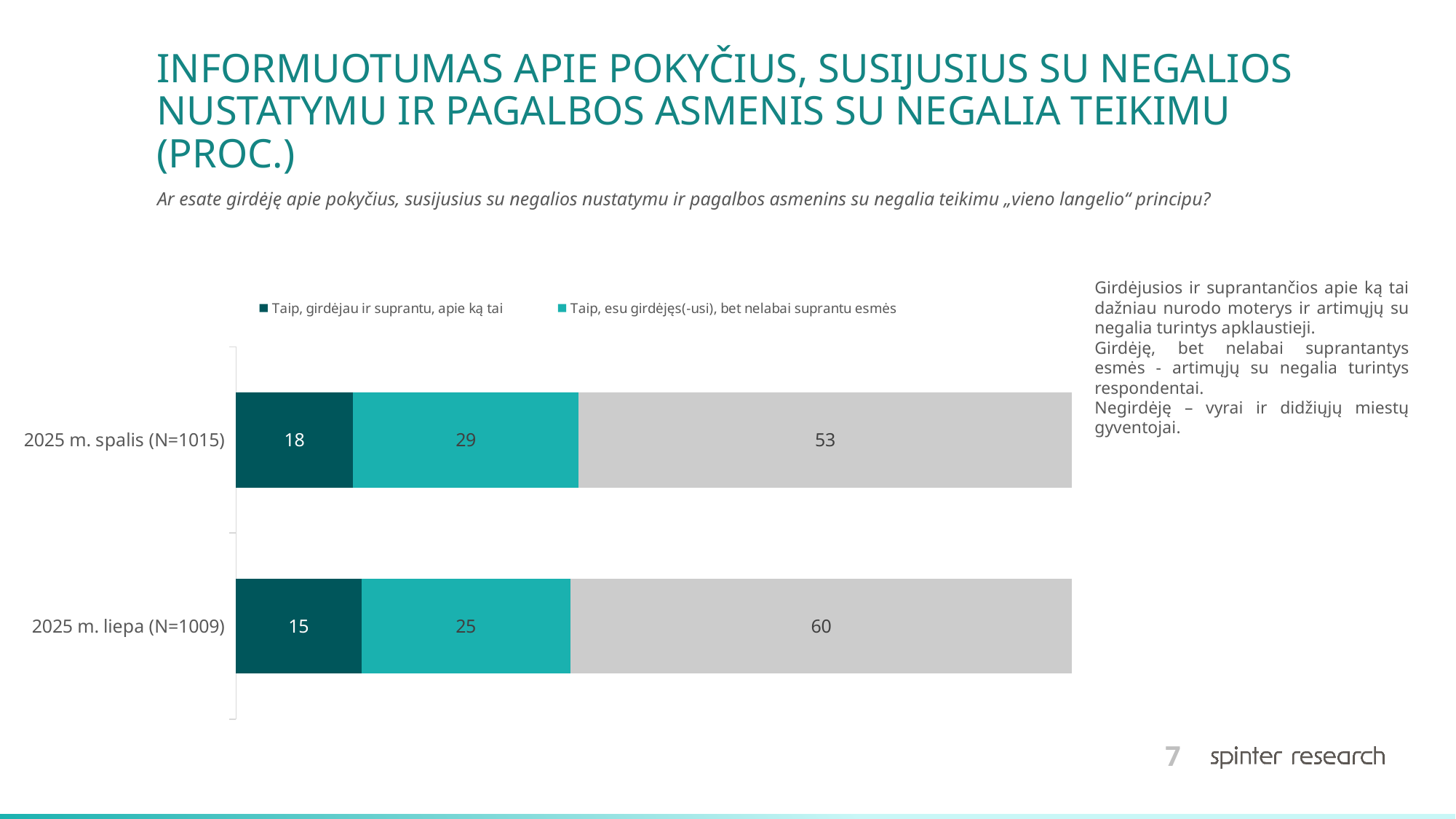
What is the value of the "Taip, esu girdėjęs(-usi), bet nelabai suprantu esmės" segment for 2025 m. liepa (N=1009)? 25 What is the total of the stacked bar for 2025 m. spalis (N=1015)? 100 What kind of chart is shown on the slide? Stacked bar chart What is the value of the grey segment for 2025 m. spalis (N=1015)? 53 What is the difference between the grey segment values for 2025 m. liepa (N=1009) and 2025 m. spalis (N=1015)? 7 How many categories (bars) does the chart show? 2 Which category has the larger value for "Taip, girdėjau ir suprantu, apie ką tai": 2025 m. spalis (N=1015) or 2025 m. liepa (N=1009)? 2025 m. spalis (N=1015) What is the difference between the "Taip, esu girdėjęs(-usi), bet nelabai suprantu esmės" values for 2025 m. spalis (N=1015) and 2025 m. liepa (N=1009)? 4 What is the first series listed in the legend? Taip, girdėjau ir suprantu, apie ką tai How many series does the legend list? 2 What is the value of the grey segment for 2025 m. liepa (N=1009)? 60 What is the value of the "Taip, girdėjau ir suprantu, apie ką tai" segment for 2025 m. spalis (N=1015)? 18